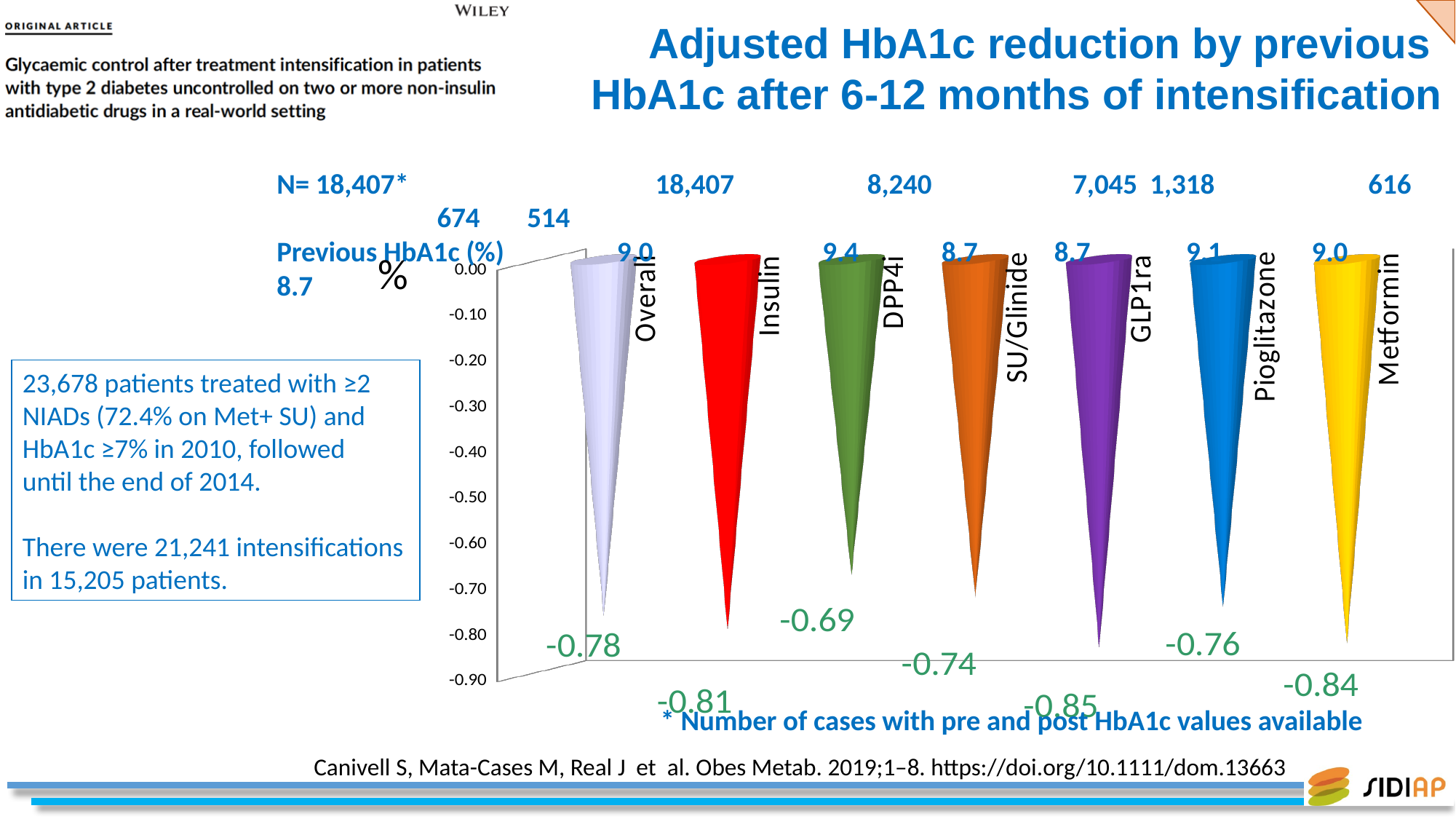
What is the adjusted HbA1c reduction for the Overall group? -0.78 Which has a larger HbA1c reduction, Insulin or Pioglitazone? Insulin How many categories are plotted in the chart? 7 What is the adjusted HbA1c reduction for Pioglitazone? -0.76 Which category shows the largest HbA1c reduction (most negative value)? GLP1ra What kind of chart is shown on the slide? bar chart Which category shows the smallest HbA1c reduction (value closest to zero)? DPP4i What is the adjusted HbA1c reduction for Insulin? -0.81 What colour is the bar for Insulin? red What is the adjusted HbA1c reduction for Metformin? -0.84 What is the difference between the HbA1c reduction for SU/Glinide and for DPP4i? 0.05 What is the adjusted HbA1c reduction for DPP4i? -0.69